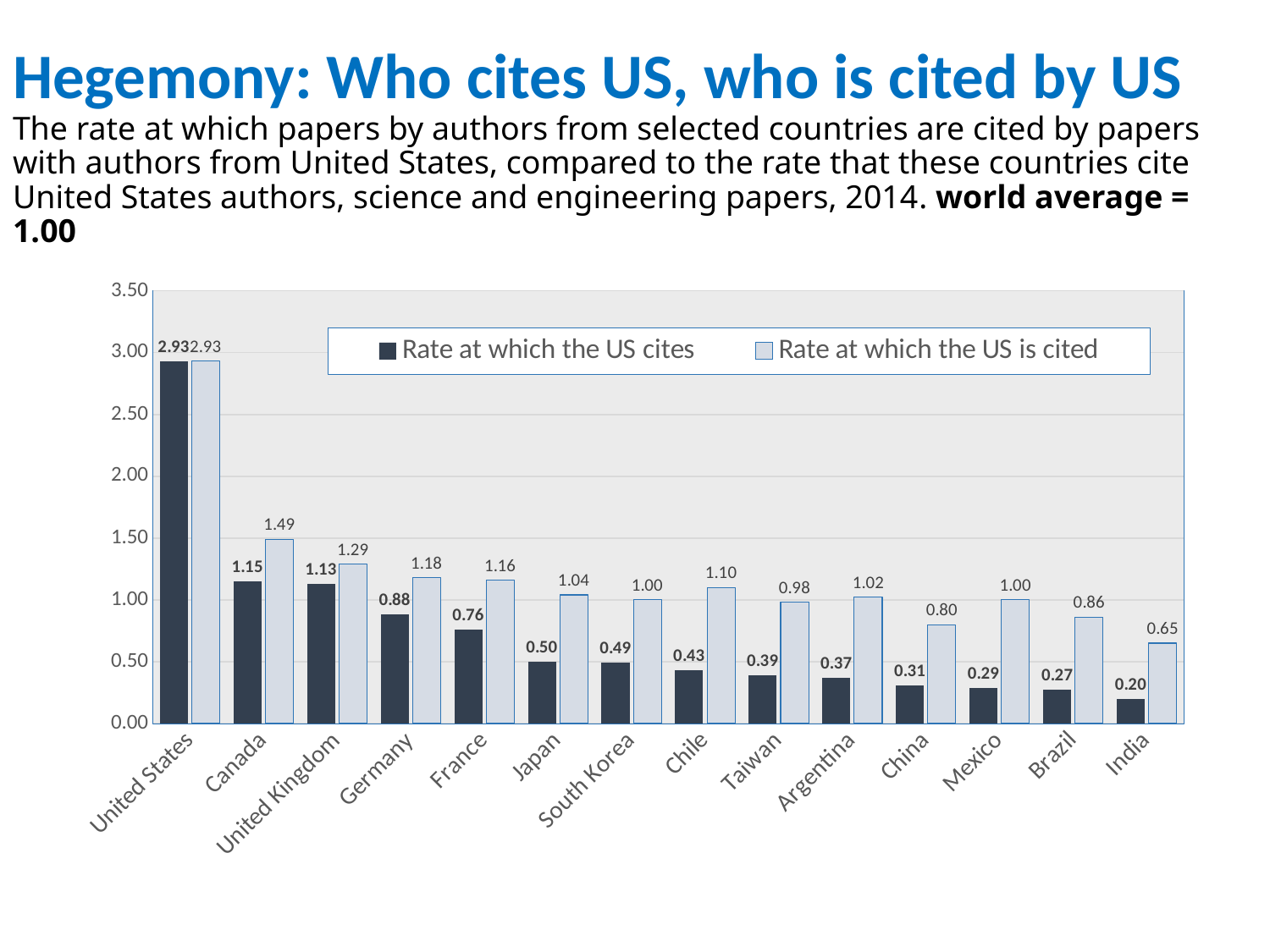
What is the 'Rate at which the US is cited' value for Brazil? 0.86 What is the difference between the 'Rate at which the US is cited' and the 'Rate at which the US cites' for Japan? 0.54 For China, which is larger: the 'Rate at which the US cites' or the 'Rate at which the US is cited'? Rate at which the US is cited Which country has the highest 'Rate at which the US is cited' value, excluding the United States? Canada What kind of chart is shown on the slide? Bar chart What is the 'Rate at which the US cites' value for Canada? 1.15 What is the 'Rate at which the US cites' value for India? 0.20 How many series does the legend list? 2 How many countries are shown on the x axis? 14 Do the 'Rate at which the US cites' values rise or fall from left to right along the x axis? Fall Which country has the lowest 'Rate at which the US cites' value? India What is the 'Rate at which the US is cited' value for Germany? 1.18